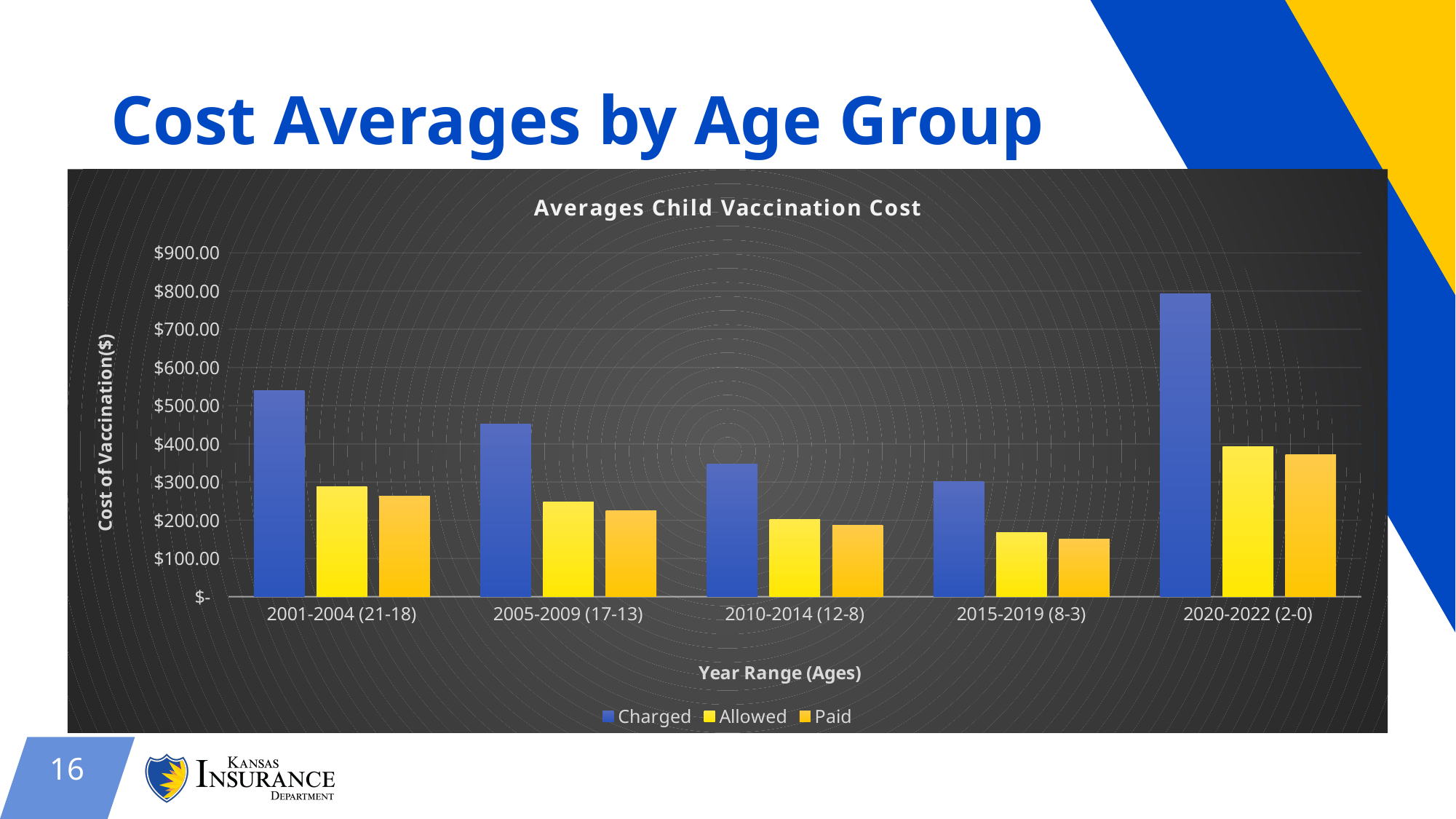
Is the Charged value for 2001-2004 (21-18) greater or less than $500.00? greater Do the Charged values rise or fall from 2001-2004 (21-18) through 2015-2019 (8-3)? fall Which year range has the highest Charged value? 2020-2022 (2-0) What kind of chart is shown on the slide? Bar chart What is the label on the vertical axis of the chart? Cost of Vaccination($) Is the Charged value for 2020-2022 (2-0) greater or less than $700.00? greater What is the title of the chart? Averages Child Vaccination Cost Is the Allowed value for 2015-2019 (8-3) greater or less than $200.00? less How many year-range categories are shown on the x axis? 5 How many series does the legend list? 3 Which is larger: the Charged value for 2005-2009 (17-13) or the Charged value for 2010-2014 (12-8)? 2005-2009 (17-13) Which year range has the lowest Charged value? 2015-2019 (8-3)